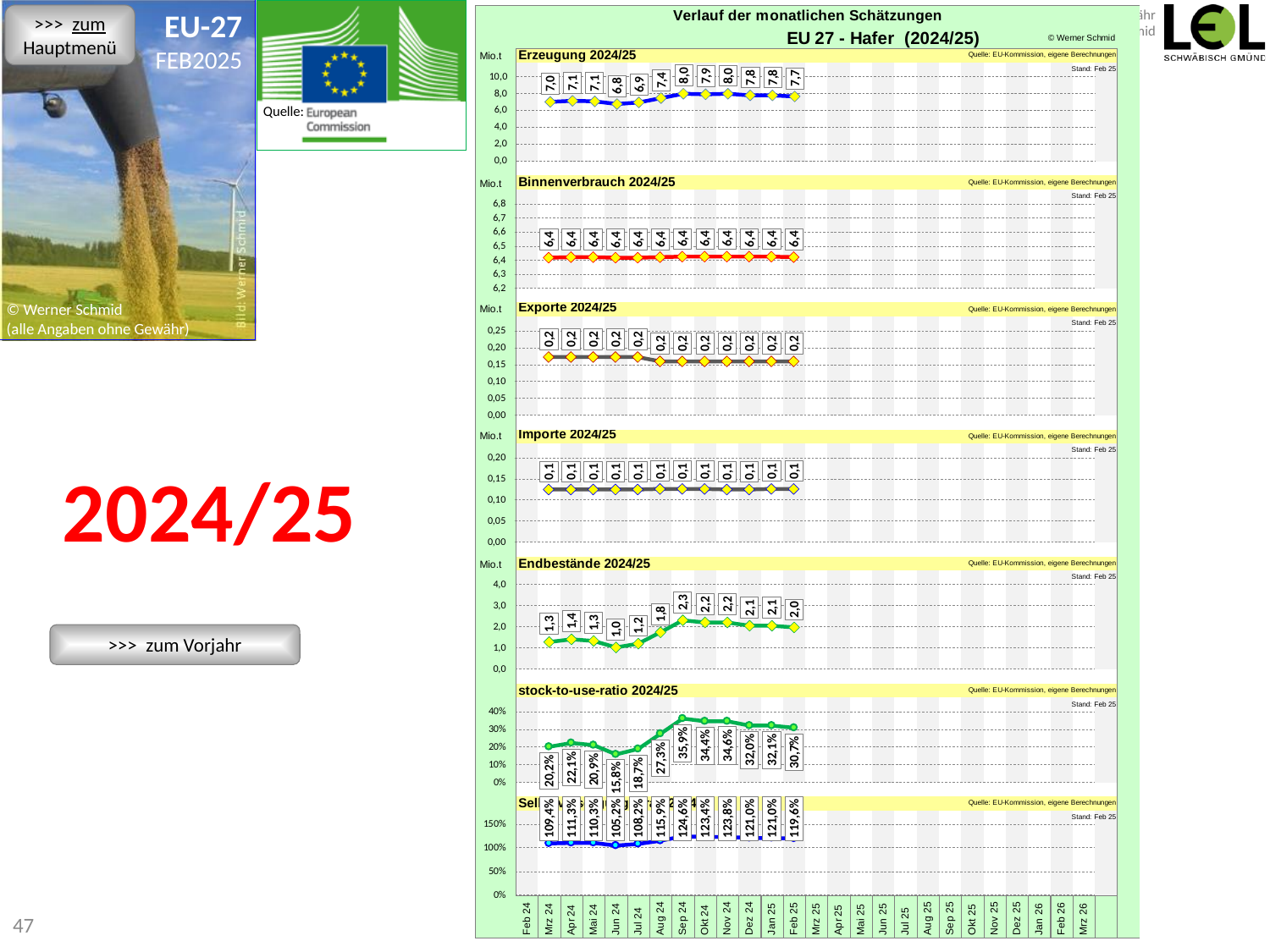
How many data points are plotted in the 'Erzeugung 2024/25' chart? 12 In the 'Endbestände 2024/25' chart, what is the difference between the highest and the lowest value? 1,3 In the 'Erzeugung 2024/25' chart, which is larger: the first data point or the last data point? the last data point (7,7) In the 'Endbestände 2024/25' chart, what is the lowest value shown? 1,0 What kind of chart is the 'Endbestände 2024/25' chart? line chart In the 'Binnenverbrauch 2024/25' chart, what value is shown for every data point? 6,4 In the 'Erzeugung 2024/25' chart, what is the value of the last (most recent, Feb 25) data point? 7,7 In the 'Erzeugung 2024/25' chart, what is the highest value shown? 8,0 In the 'stock-to-use-ratio 2024/25' chart, what is the highest value shown? 35,9% In the 'Erzeugung 2024/25' chart, what is the lowest value shown? 6,8 In the 'stock-to-use-ratio 2024/25' chart, what is the value of the last (Feb 25) data point? 30,7% In the 'Endbestände 2024/25' chart, what is the highest value shown? 2,3